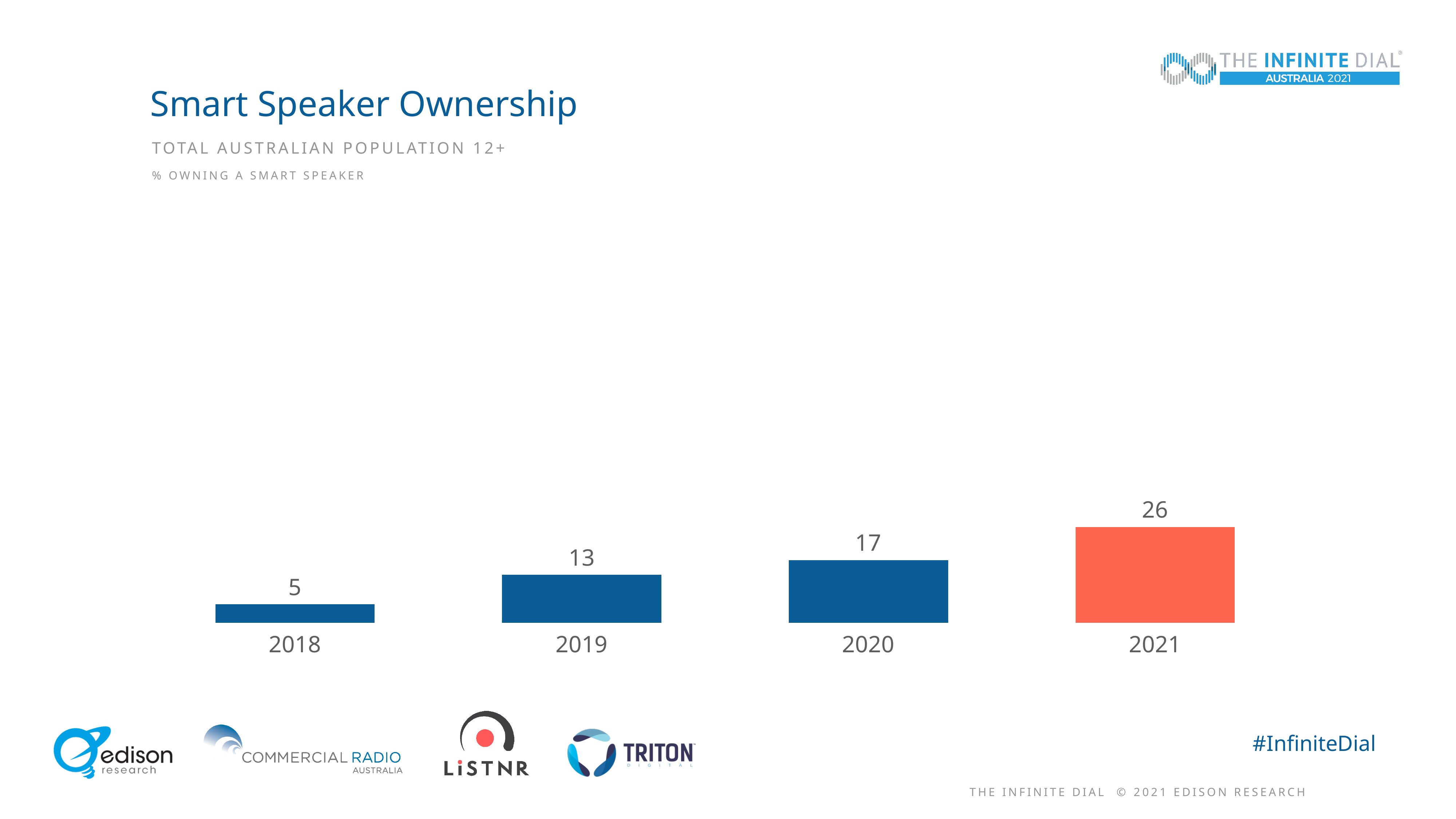
What is the difference between the values for 2019 and 2018? 8 What is the value for 2021? 26 What is the value for 2020? 17 What is the value for 2018? 5 What is the value for 2019? 13 What is the difference between the values for 2021 and 2020? 9 What kind of chart is this? bar chart How many years are shown on the chart? 4 Which year has the highest value? 2021 Which year has the lowest value? 2018 Which is larger, the value for 2019 or the value for 2020? 2020 Do the values rise or fall from 2018 to 2021? rise